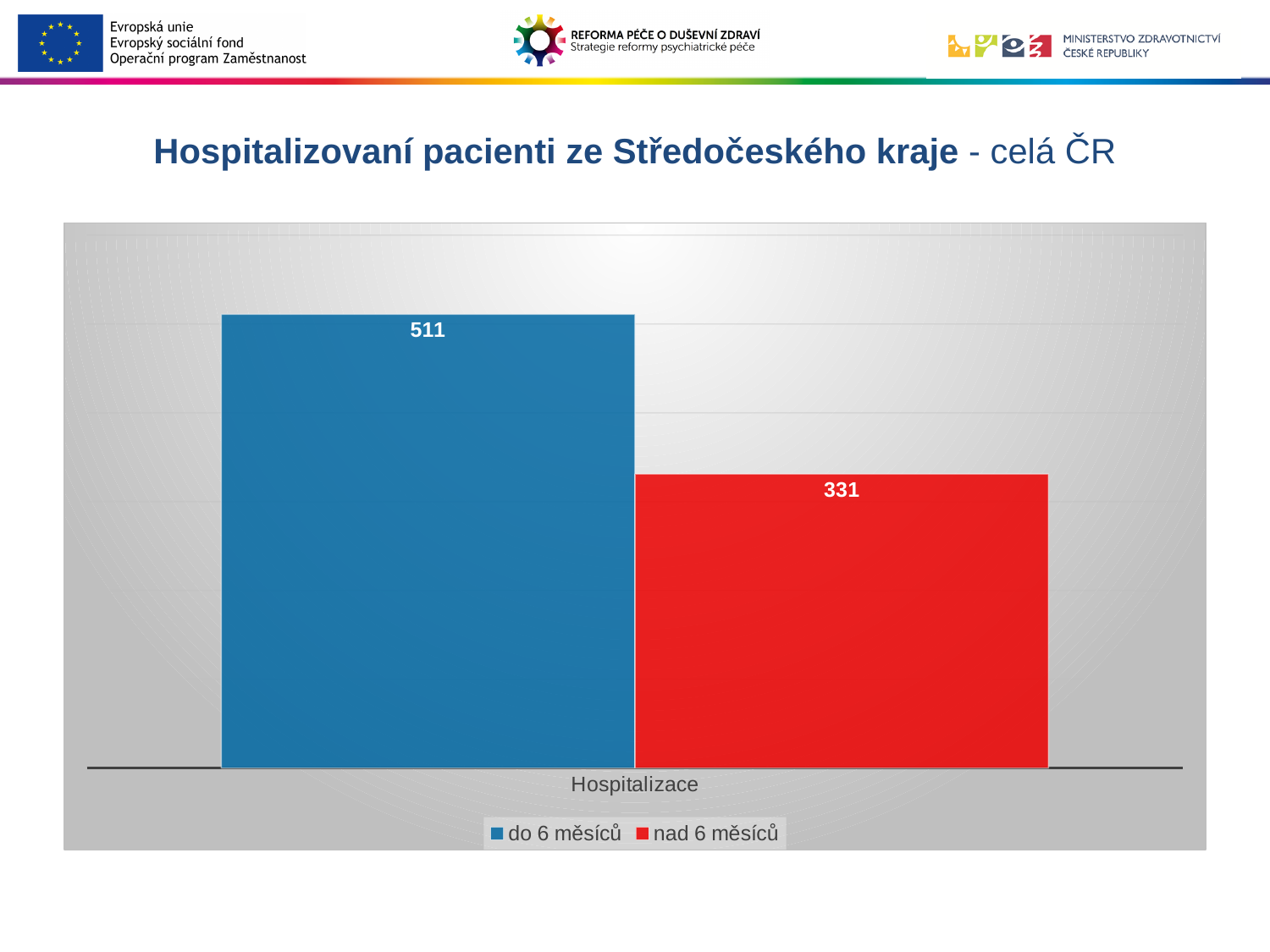
What kind of chart is shown on the slide? bar chart How many series does the legend list? 2 Is the value for "do 6 měsíců" larger or smaller than the value for "nad 6 měsíců"? larger What is the difference between the values for "do 6 měsíců" and "nad 6 měsíců"? 180 How many categories are shown on the x axis? 1 Which series has the higher value? do 6 měsíců What is the value for "nad 6 měsíců"? 331 What is the total of the two plotted values? 842 Which series has the lower value? nad 6 měsíců What colour is the bar for "nad 6 měsíců"? red What is the value for "do 6 měsíců"? 511 What is the label of the category on the x axis? Hospitalizace